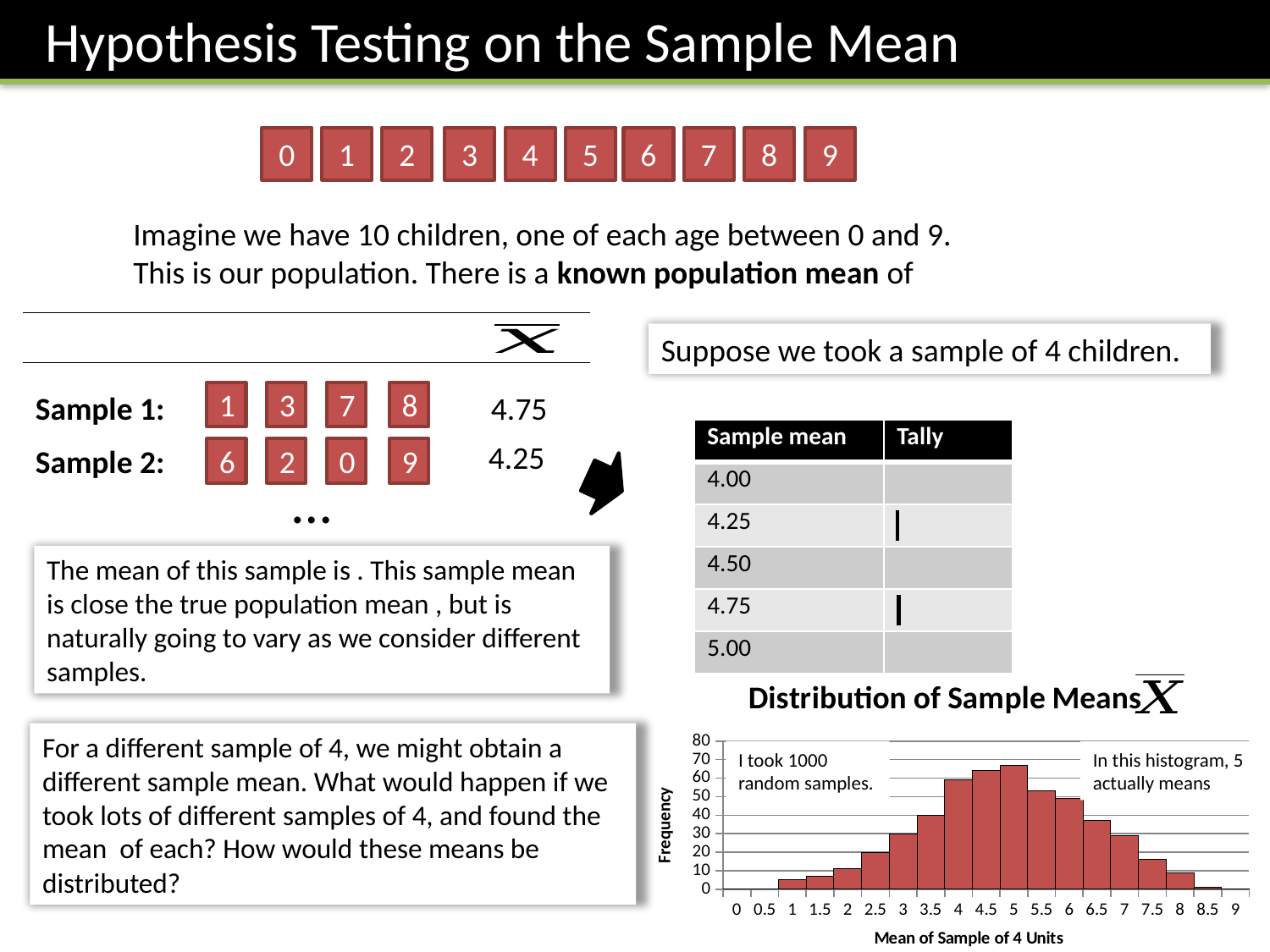
In the "Distribution of Sample Means" chart, which has the higher frequency: a sample mean of 4 or a sample mean of 7? 4 In the "Distribution of Sample Means" chart, which sample mean has the highest frequency? 5 What kind of chart is shown under the title "Distribution of Sample Means"? bar chart In the "Distribution of Sample Means" chart, is the frequency for a sample mean of 3 greater or less than 40? less In the "Distribution of Sample Means" chart, is the frequency for a sample mean of 5 greater or less than 60? greater In the "Distribution of Sample Means" chart, is the frequency for a sample mean of 7.5 greater or less than 20? less In the "Distribution of Sample Means" chart, do the frequencies rise or fall as the sample mean increases from 1 to 5? rise What is the label on the x axis of the "Distribution of Sample Means" chart? Mean of Sample of 4 Units What is the label on the y axis of the "Distribution of Sample Means" chart? Frequency In the "Distribution of Sample Means" chart, which has the higher frequency: a sample mean of 3 or a sample mean of 6? 6